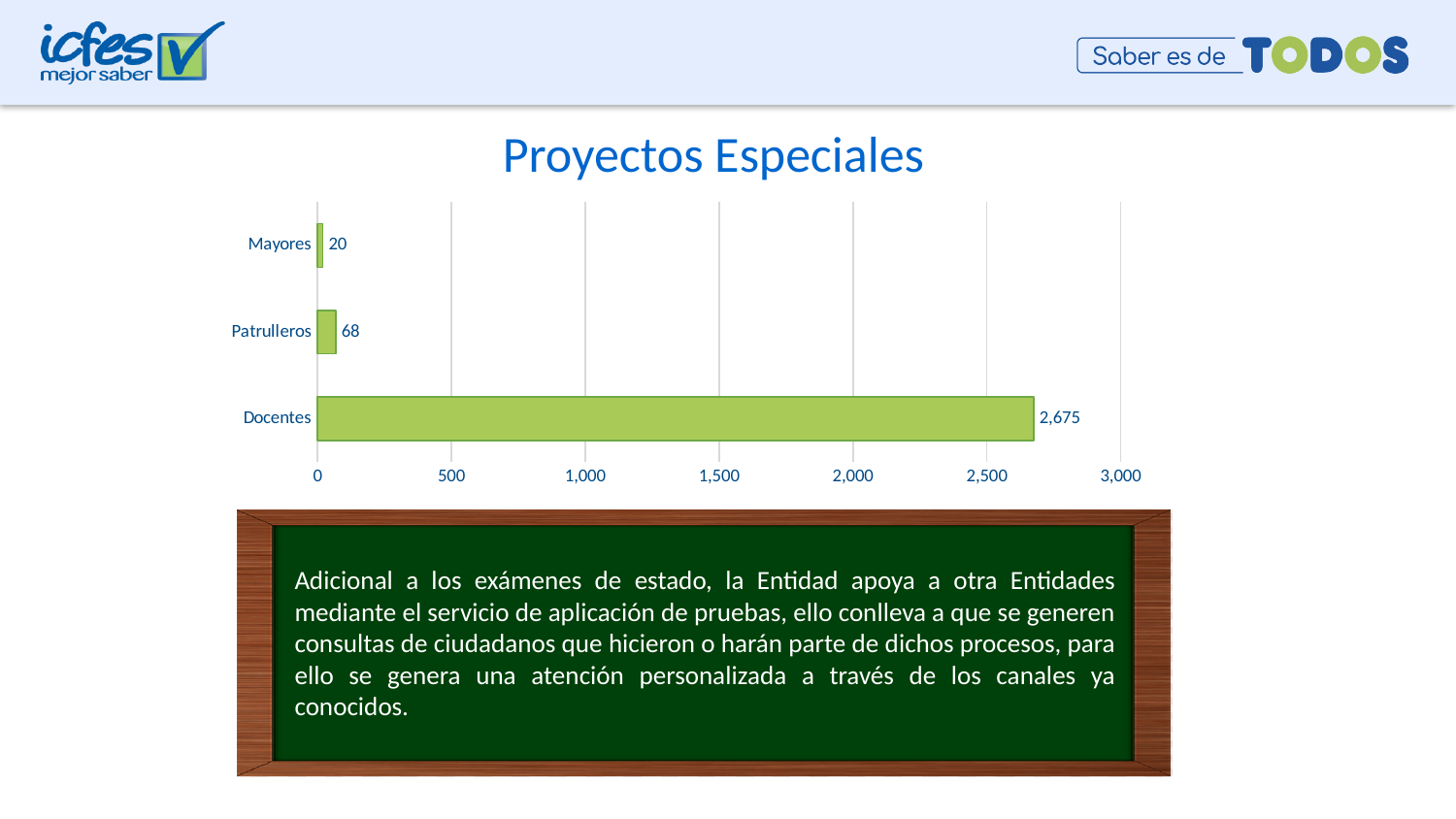
Is the value for Docentes greater or less than 2,500? greater What kind of chart is shown on the slide? Bar chart How many categories are shown in the chart? 3 What is the difference between the values for Docentes and Patrulleros? 2,607 Which category has the highest value? Docentes What is the value for Docentes? 2,675 What is the difference between the values for Patrulleros and Mayores? 48 What is the title of the chart? Proyectos Especiales What is the value for Patrulleros? 68 Which category has the lowest value? Mayores Which is larger, the value for Patrulleros or the value for Mayores? Patrulleros What is the value for Mayores? 20